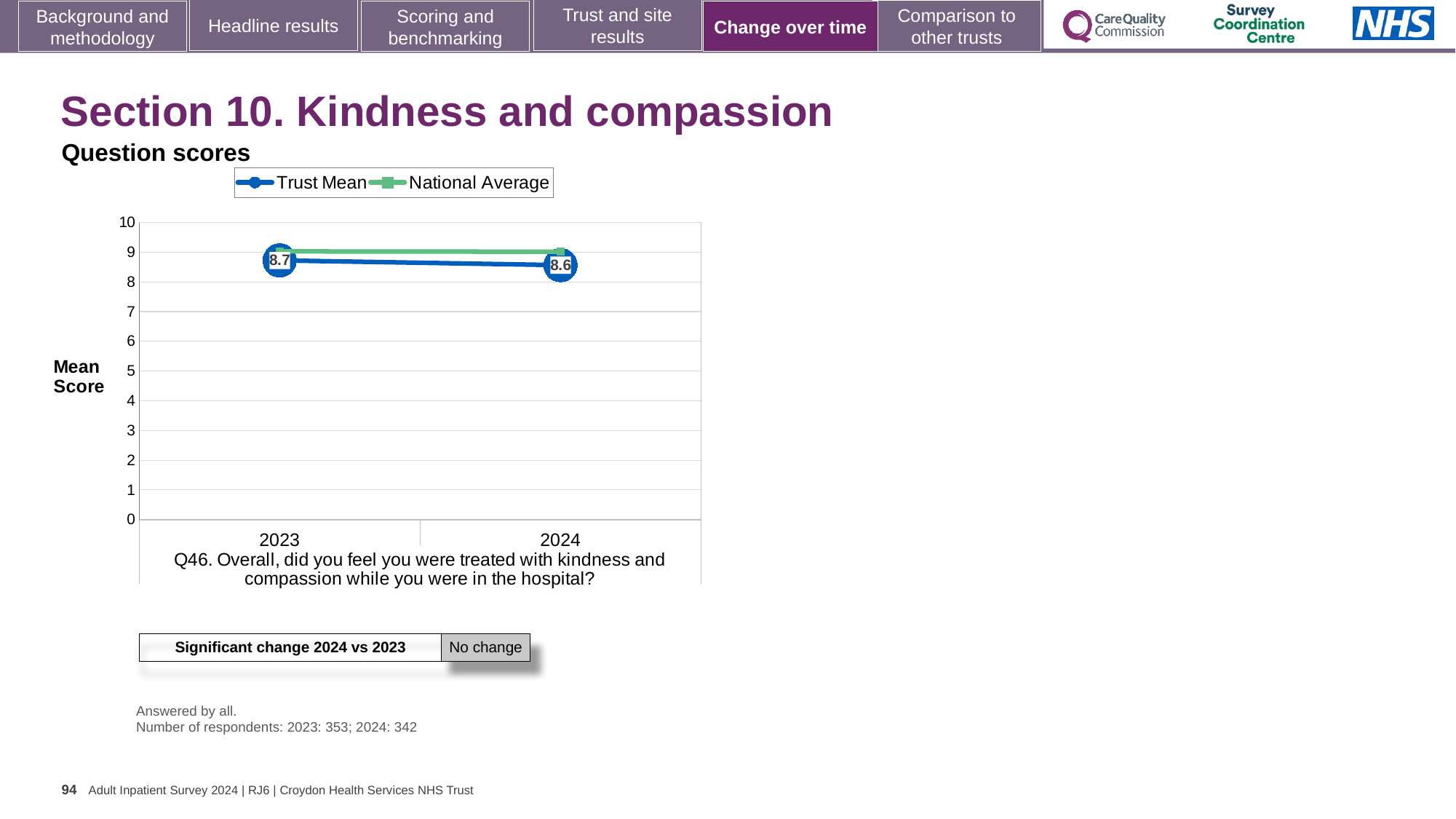
What is the Trust Mean score for 2024? 8.6 How many years are plotted on the x axis? 2 What is the difference between the Trust Mean scores for 2023 and 2024? 0.1 Which year has the lower Trust Mean score? 2024 Is the National Average value for 2023 greater or less than 8? greater How many series does the legend list? 2 What is the label on the y axis of the chart? Mean Score In 2024, which is higher: the Trust Mean or the National Average? National Average What is the Trust Mean score for 2023? 8.7 Does the Trust Mean rise or fall from 2023 to 2024? Fall What kind of chart is shown? Line chart Which year has the higher Trust Mean score? 2023